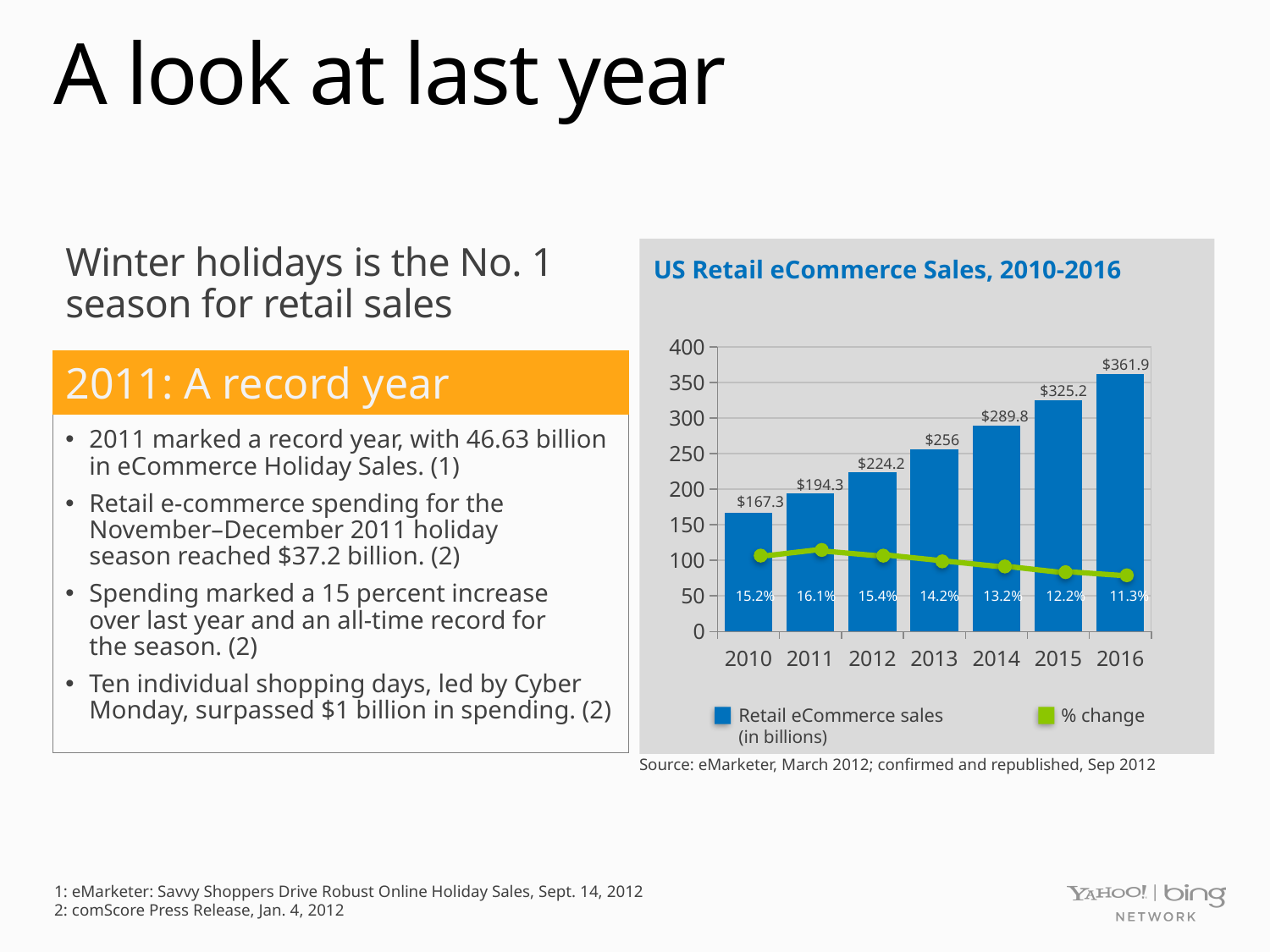
What is the difference in retail eCommerce sales between 2016 and 2015? $36.7 How many years are shown on the x axis? 7 What is the title of the chart? US Retail eCommerce Sales, 2010-2016 Which is larger, the retail eCommerce sales for 2012 or for 2014? 2014 Which year has the highest % change? 2011 What is the retail eCommerce sales value for 2016? $361.9 Do the retail eCommerce sales rise or fall from 2010 to 2016? rise What is the retail eCommerce sales value for 2013? $256 Which year has the highest retail eCommerce sales? 2016 What is the % change value shown for 2011? 16.1% How many series does the legend list? 2 Which year has the lowest % change? 2016